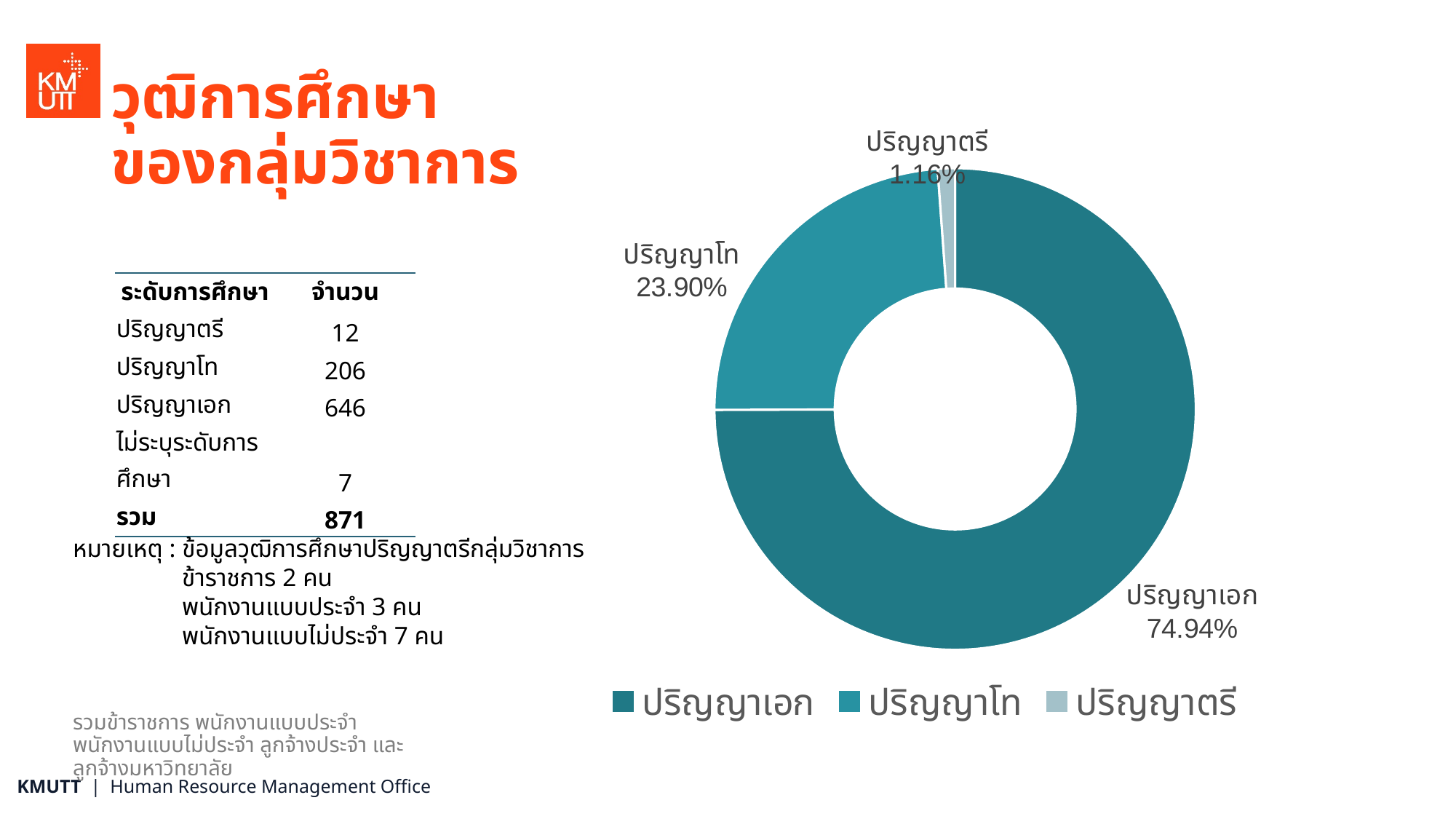
How many slices does the donut chart have? 3 What type of chart is shown on the slide? Donut (pie) chart What percentage of the donut chart is labelled ปริญญาเอก? 74.94% What is the difference in percentage points between the ปริญญาเอก and ปริญญาโท slices? 51.04 What percentage is shown for the ปริญญาโท slice? 23.90% Which legend entry is shown in the lightest colour? ปริญญาตรี How many entries does the chart legend list? 3 Which category has the largest slice in the chart? ปริญญาเอก What percentage is shown for the ปริญญาตรี slice? 1.16% Which slice is larger, ปริญญาโท or ปริญญาตรี? ปริญญาโท What is the difference in percentage points between the ปริญญาโท and ปริญญาตรี slices? 22.74 Which category has the smallest slice in the chart? ปริญญาตรี